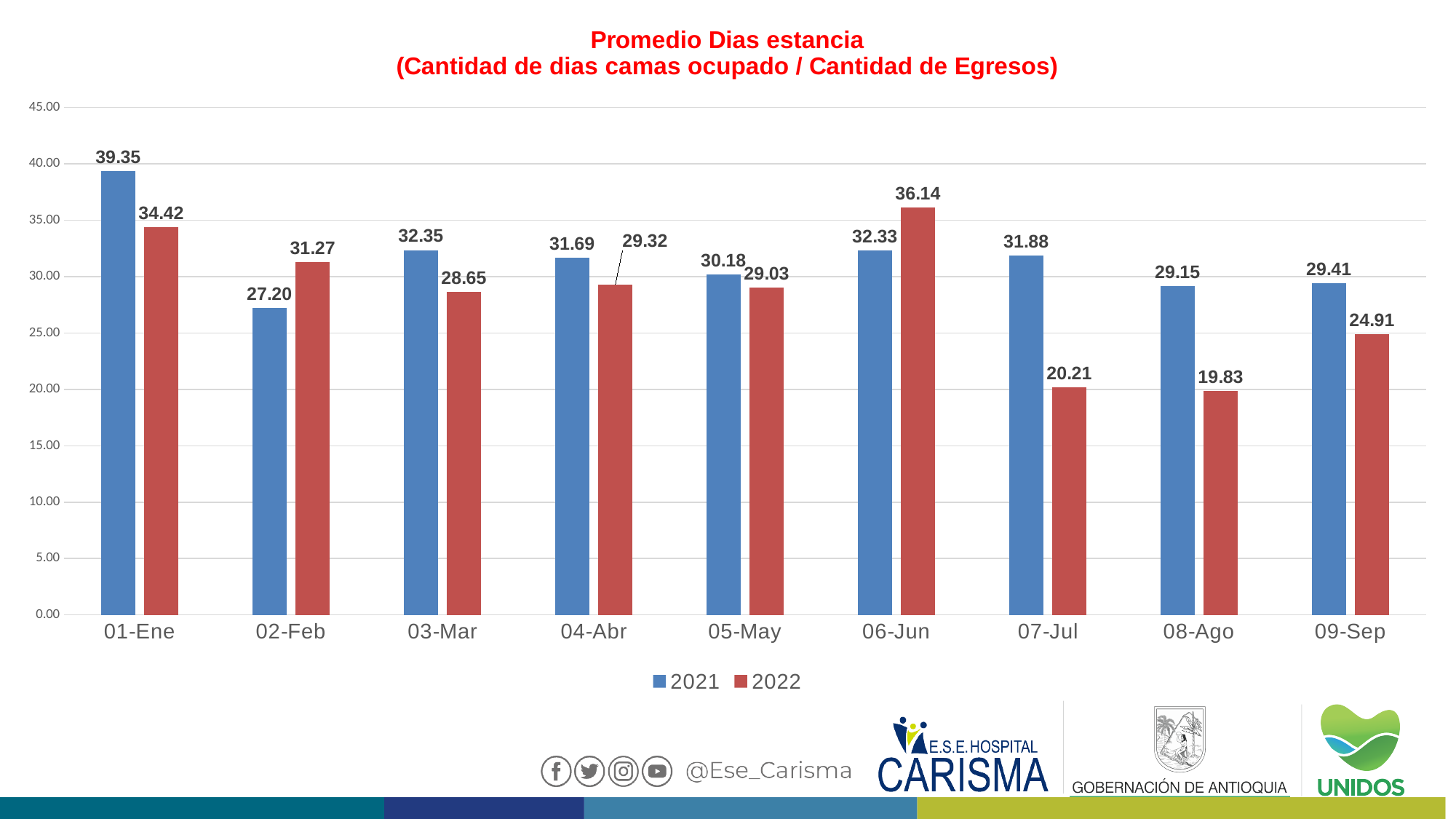
In 02-Feb, which series has the larger value, 2021 or 2022? 2022 What is the value for 2022 in 07-Jul? 20.21 Which month has the lowest value for the 2022 series? 08-Ago Is the value for 2022 in 08-Ago greater or less than 25.00? less What kind of chart is shown on the slide? bar chart What is the difference between the 2021 and 2022 values in 01-Ene? 4.93 Which month has the highest value for the 2021 series? 01-Ene How many series does the legend list? 2 How many months are shown on the x axis? 9 What is the value for 2021 in 01-Ene? 39.35 Which colour represents the 2022 series in the legend? red What is the value for 2022 in 06-Jun? 36.14